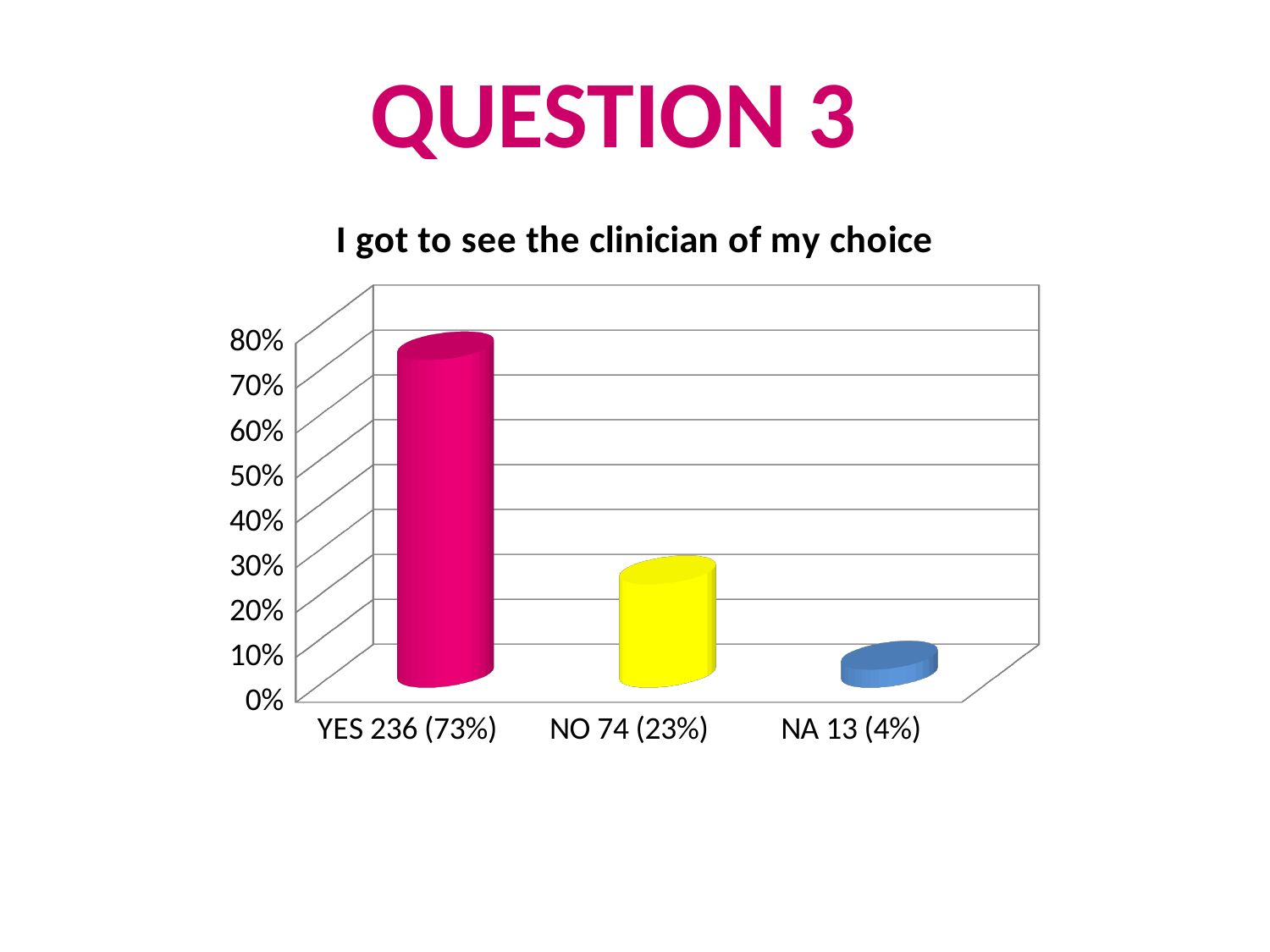
How many respondents answered YES? 236 Which is larger, the NO response or the NA response? NO What percentage of respondents answered NA? 4% Which response category has the highest value? YES What is the difference in percentage points between the YES and NO responses? 50 How many response categories are shown on the chart? 3 What is the title of the chart? I got to see the clinician of my choice How many respondents answered NO? 74 What kind of chart is shown on the slide? Bar chart What percentage of respondents answered YES to "I got to see the clinician of my choice"? 73% Which response category has the lowest value? NA How many more respondents answered NO than NA? 61